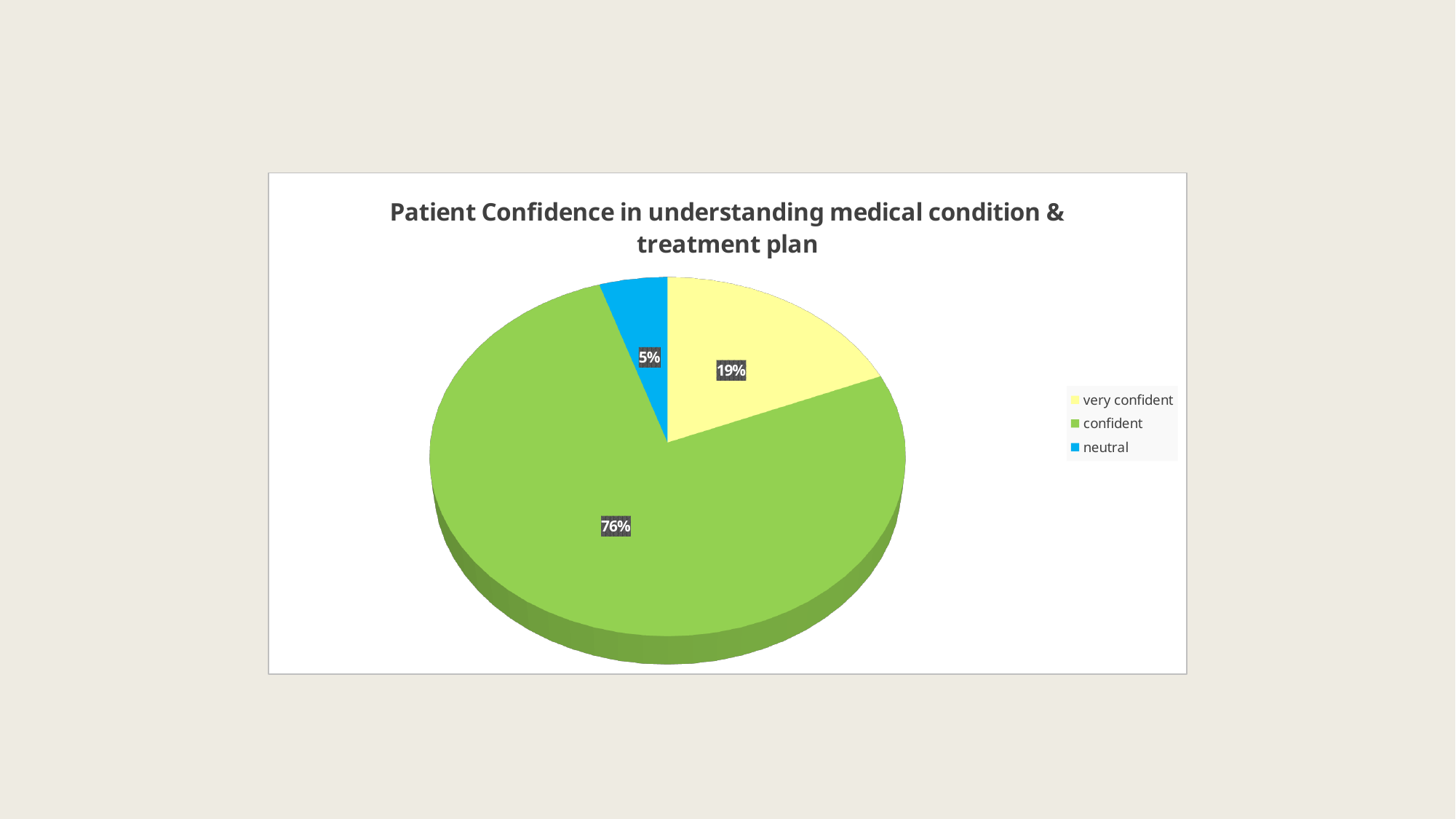
What kind of chart is shown on the slide? pie chart What colour is the 'neutral' slice in the pie chart? blue What share of the pie is labelled 'confident'? 76% Which category has the largest slice of the pie? confident What is the difference in percentage points between the 'very confident' and 'neutral' slices? 14 What is the difference in percentage points between the 'confident' and 'very confident' slices? 57 What share of the pie is labelled 'very confident'? 19% What is the title of the chart? Patient Confidence in understanding medical condition & treatment plan Which category has the smallest slice of the pie? neutral What share of the pie is labelled 'neutral'? 5% How many categories does the pie chart show? 3 Which is larger, the 'very confident' slice or the 'neutral' slice? very confident